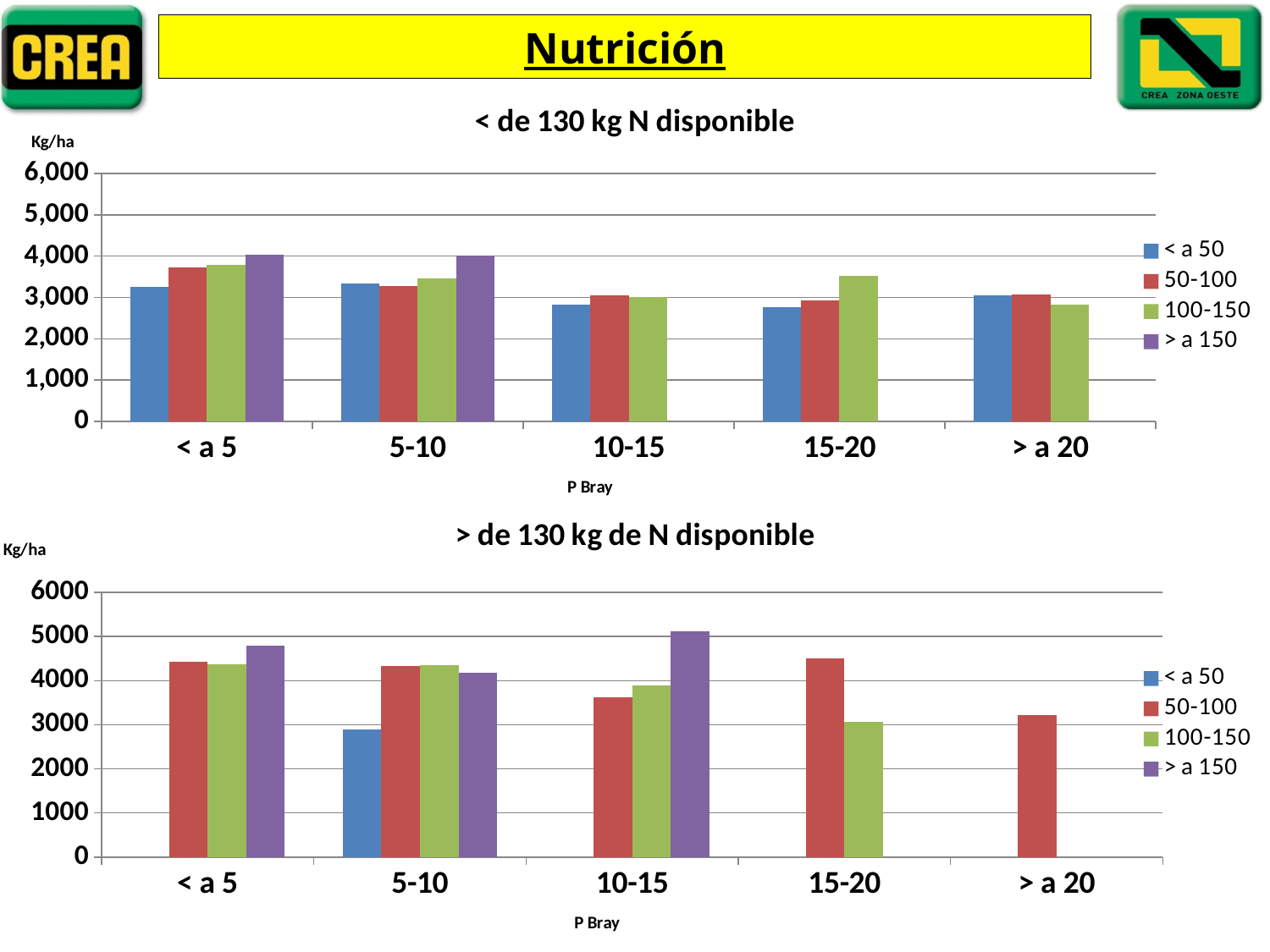
In the '> de 130 kg de N disponible' chart, for the '5-10' category, which is larger: '< a 50' or '50-100'? 50-100 In the '> de 130 kg de N disponible' chart, is the value for '50-100' in the '> a 20' category greater or less than 3000? greater How many P Bray categories are shown on the x axis of the '> de 130 kg de N disponible' chart? 5 In the '> de 130 kg de N disponible' chart, how many bars are plotted in the '> a 20' category? 1 In the '< de 130 kg N disponible' chart, is the value for '< a 50' in the '15-20' category greater or less than 3,000? less In the '< de 130 kg N disponible' chart, which series has the highest bar in the '< a 5' category? > a 150 How many series does the legend of the '< de 130 kg N disponible' chart list? 4 What kind of chart is the '< de 130 kg N disponible' chart? bar chart In the '> de 130 kg de N disponible' chart, which series has the highest bar in the '10-15' category? > a 150 In the '< de 130 kg N disponible' chart, which series has the lowest bar in the '15-20' category? < a 50 In the '> de 130 kg de N disponible' chart, is the value for '> a 150' in the '10-15' category greater or less than 4000? greater What unit is shown on the y axis of the '< de 130 kg N disponible' chart? Kg/ha